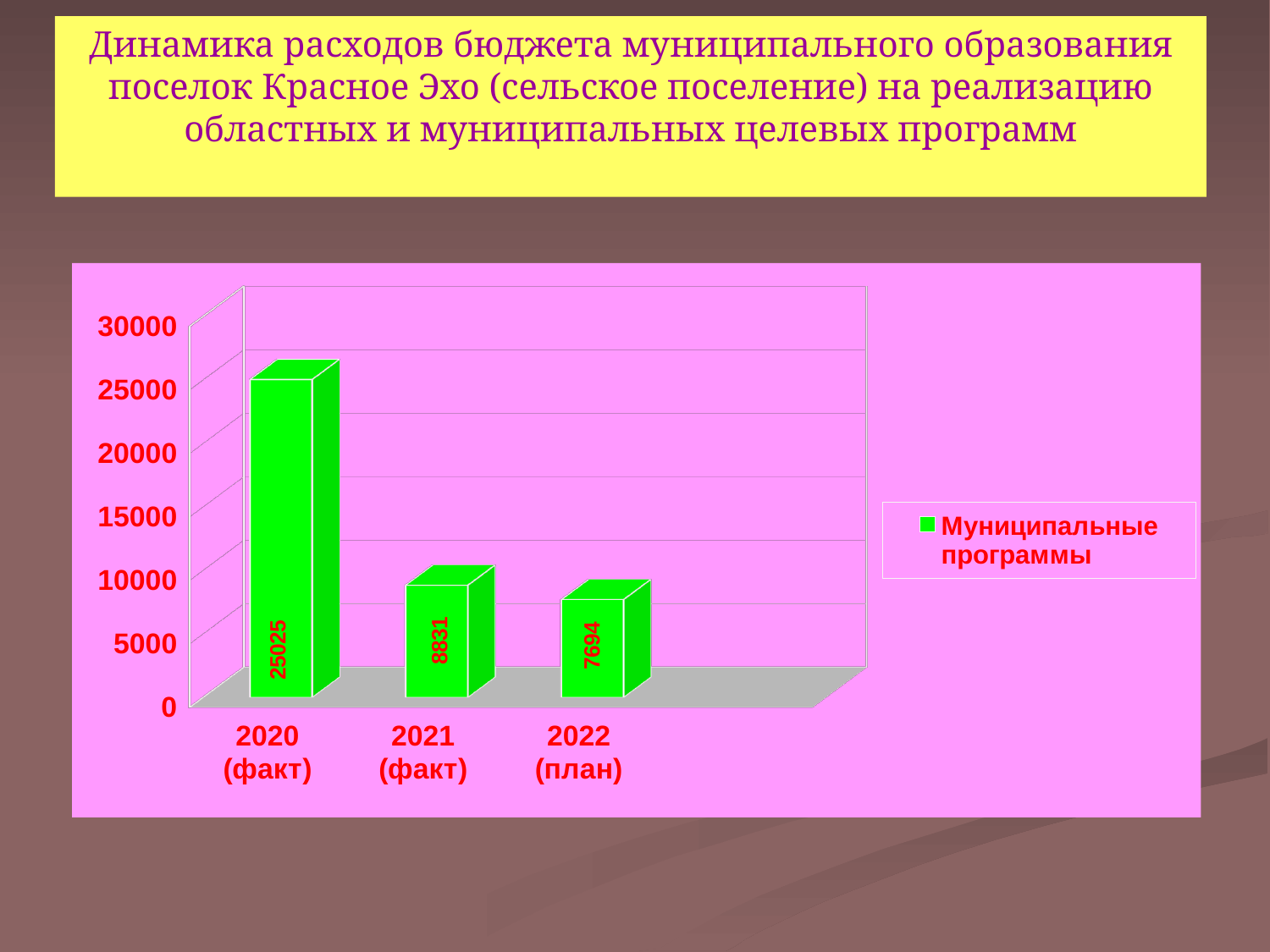
Which category has the lowest value? 2022 (план) What is the difference between the values for 2020 (факт) and 2021 (факт)? 16194 How many categories are shown on the x axis? 3 Which is larger, the value for 2021 (факт) or 2022 (план)? 2021 (факт) Which category has the highest value? 2020 (факт) What is the value for 2020 (факт)? 25025 Do the values rise or fall from 2020 to 2022? fall Is the value for 2020 (факт) greater or less than 20000? greater What is the value for 2022 (план)? 7694 What is the difference between the values for 2021 (факт) and 2022 (план)? 1137 What is the value for 2021 (факт)? 8831 What kind of chart is shown on the slide? bar chart